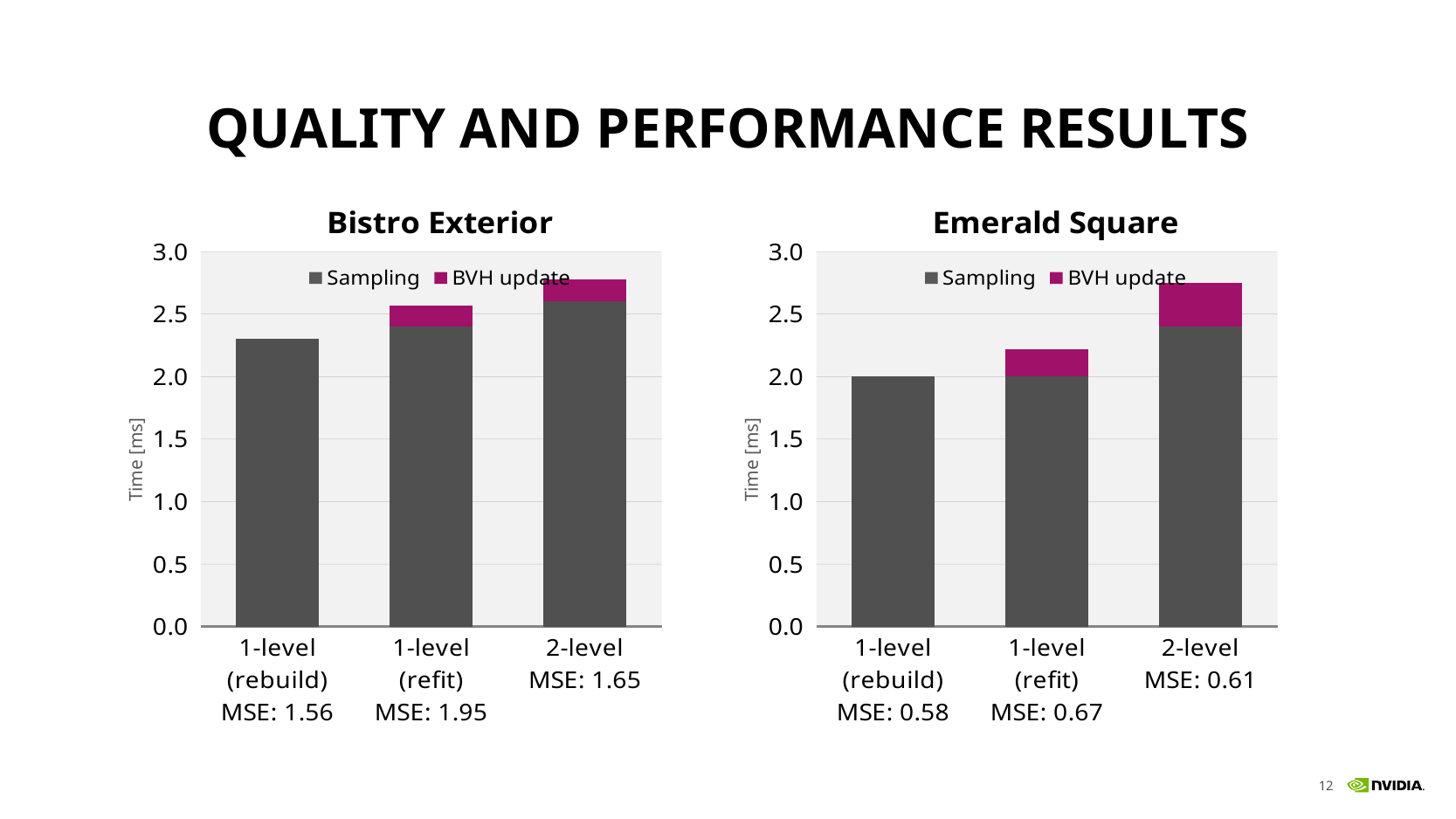
In the Bistro Exterior chart, which category has the tallest total bar? 2-level What is the y-axis label on the Emerald Square chart? Time [ms] What MSE value is shown under the 2-level category in the Emerald Square chart? MSE: 0.61 In the Emerald Square chart, is the Sampling value for 2-level greater or less than 2.5? less What kind of chart is the Bistro Exterior chart? bar chart How many series does the legend of the Emerald Square chart list? 2 How many categories are shown on the x axis of the Bistro Exterior chart? 3 In the Bistro Exterior chart, is the Sampling value for 1-level (rebuild) greater or less than 2.0? greater In the Emerald Square chart, which is larger: the BVH update segment for 1-level (refit) or for 2-level? 2-level In the Emerald Square chart, is the total bar for 2-level greater or less than 2.5? greater In the Bistro Exterior chart, do the total bar heights rise or fall from left to right across the categories? rise In the Emerald Square chart, which category has the shortest total bar? 1-level (rebuild)